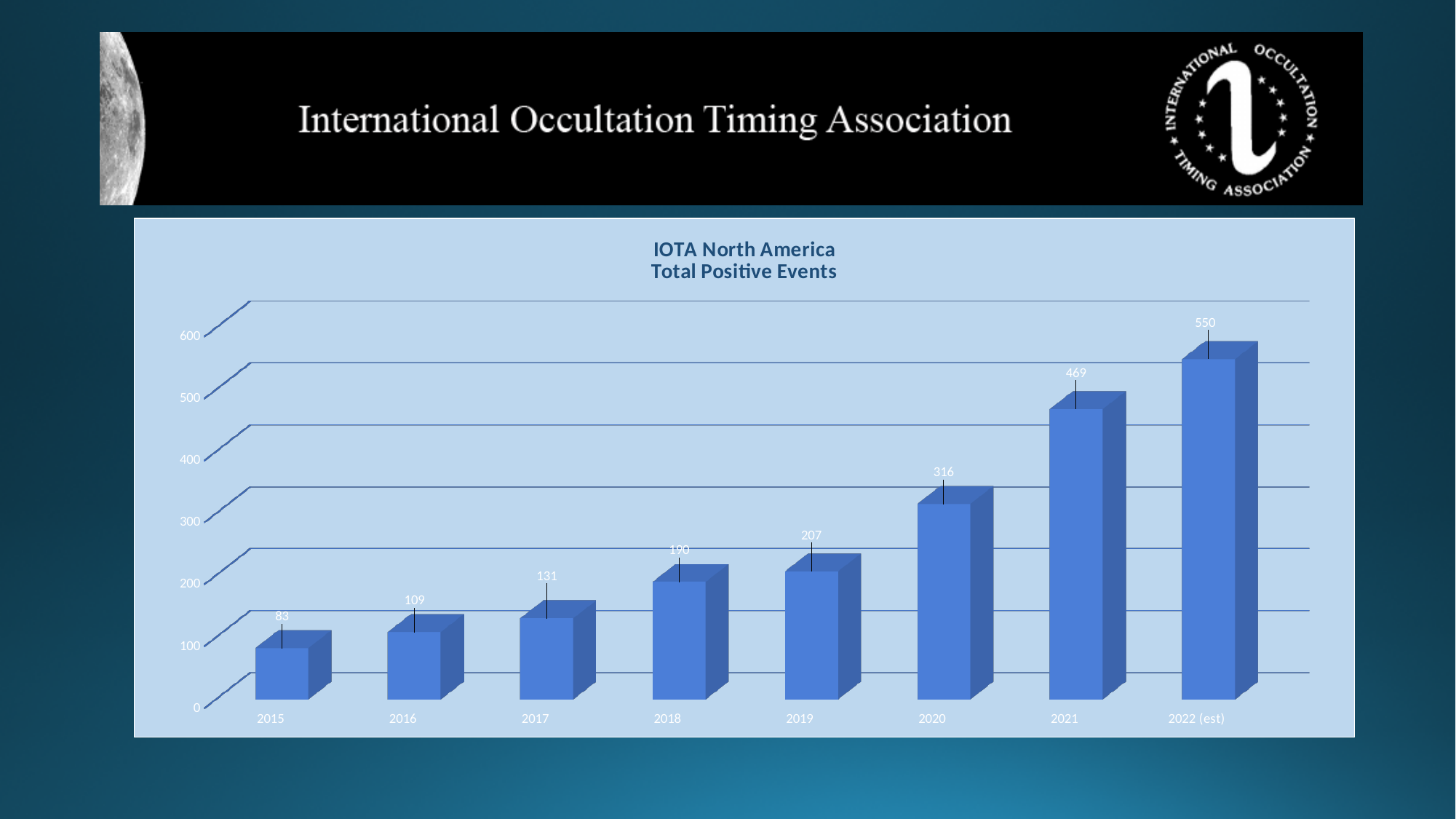
What is the difference between the values for 2019 and 2018? 17 What is the value for 2020? 316 Is the value for 2021 greater or less than 400? greater How many years are shown on the x axis? 8 What is the value for 2015? 83 What is the value for 2022 (est)? 550 Which year has the lowest value? 2015 Which is larger, the value for 2017 or the value for 2016? 2017 What kind of chart is shown? bar chart Which year has the highest value? 2022 (est) Do the values rise or fall from 2015 to 2022 (est)? rise What is the difference between the values for 2021 and 2020? 153